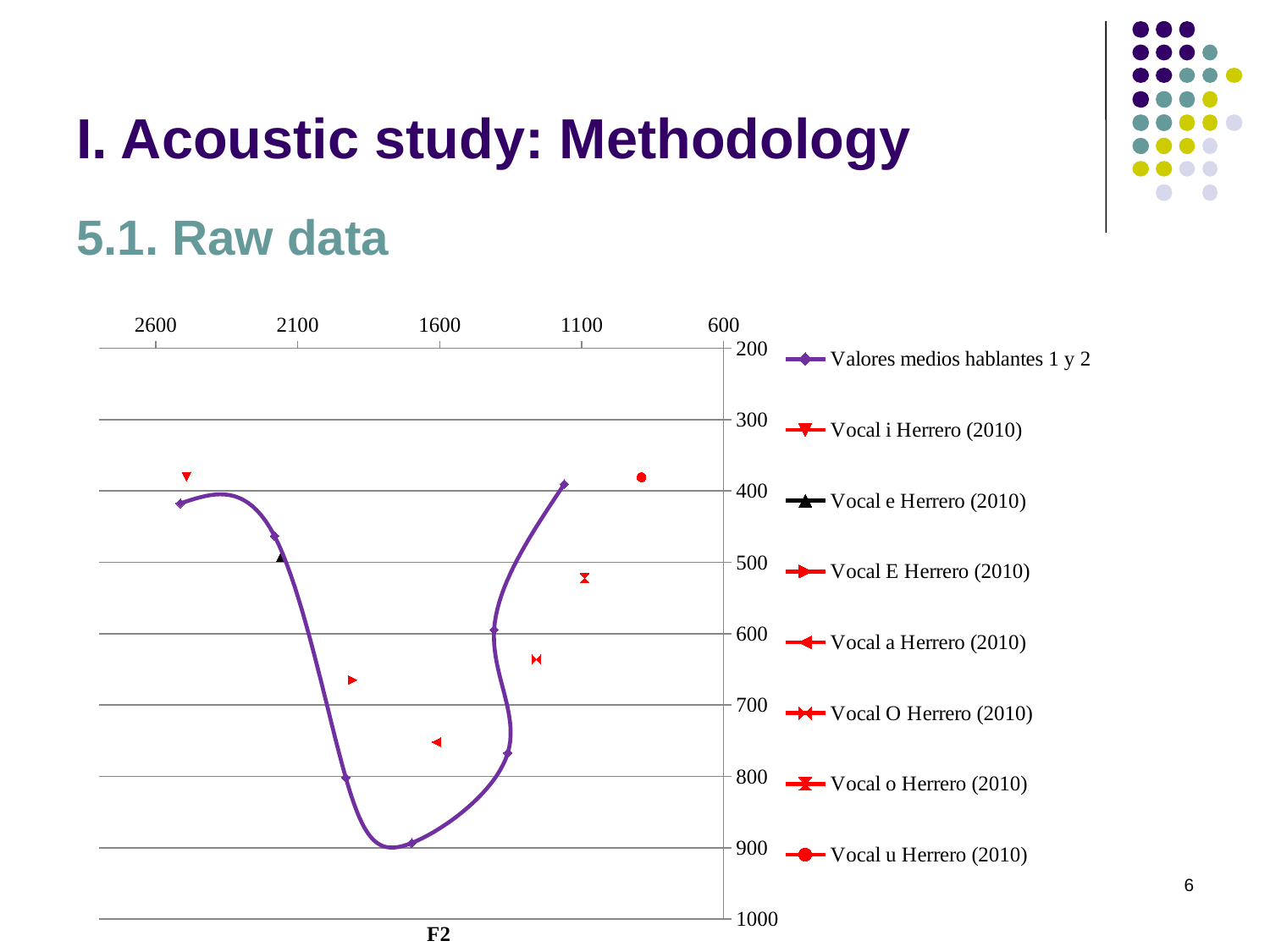
How many series does the legend list? 8 How many data points are plotted on the 'Valores medios hablantes 1 y 2' line? 7 Is the vertical-axis value for 'Vocal a Herrero (2010)' greater or less than 700? greater Which has the larger vertical-axis value, 'Vocal a Herrero (2010)' or 'Vocal i Herrero (2010)'? Vocal a Herrero (2010) Is the vertical-axis value for 'Vocal i Herrero (2010)' greater or less than 400? less Among the Herrero (2010) vowel points, which has the highest vertical-axis value? Vocal a Herrero (2010) What is the label of the horizontal axis? F2 Is the vertical-axis value for 'Vocal o Herrero (2010)' greater or less than 600? less What kind of chart is shown on the slide? Scatter chart What colour is the line for the series 'Valores medios hablantes 1 y 2'? Purple